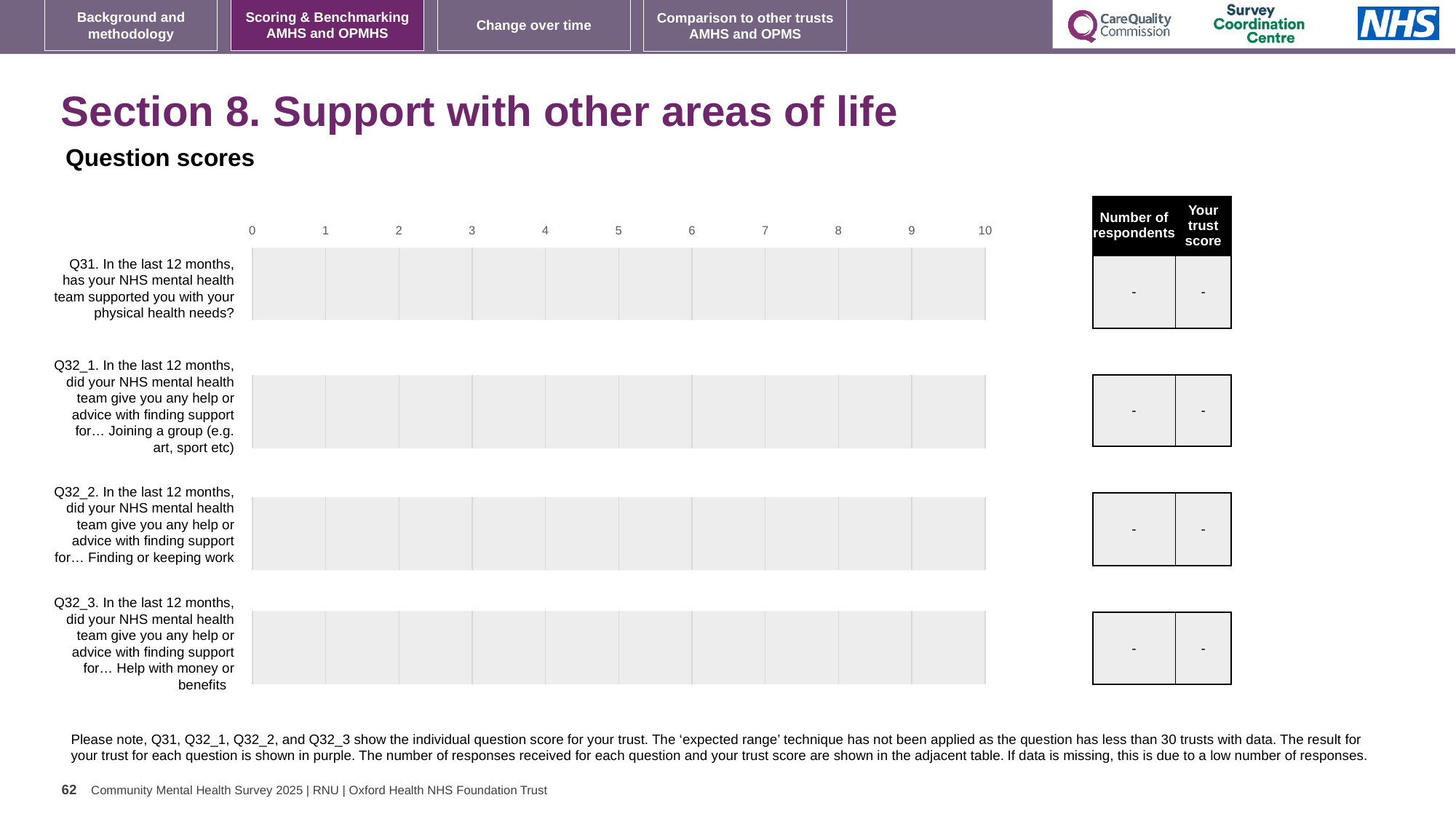
Which question label on the chart refers to 'physical health needs'? Q31 What is the 'Number of respondents' shown for Q32_1 in the adjacent table? - What is the lowest value shown on the chart's horizontal axis? 0 What is the 'Your trust score' shown for Q32_3 in the adjacent table? - How many questions (categories) are listed on the chart's vertical axis? 4 What is the 'Your trust score' shown for Q31 in the adjacent table? - What is the highest value shown on the chart's horizontal axis? 10 What kind of chart is shown under 'Question scores'? bar chart Which question label on the chart refers to 'Finding or keeping work'? Q32_2